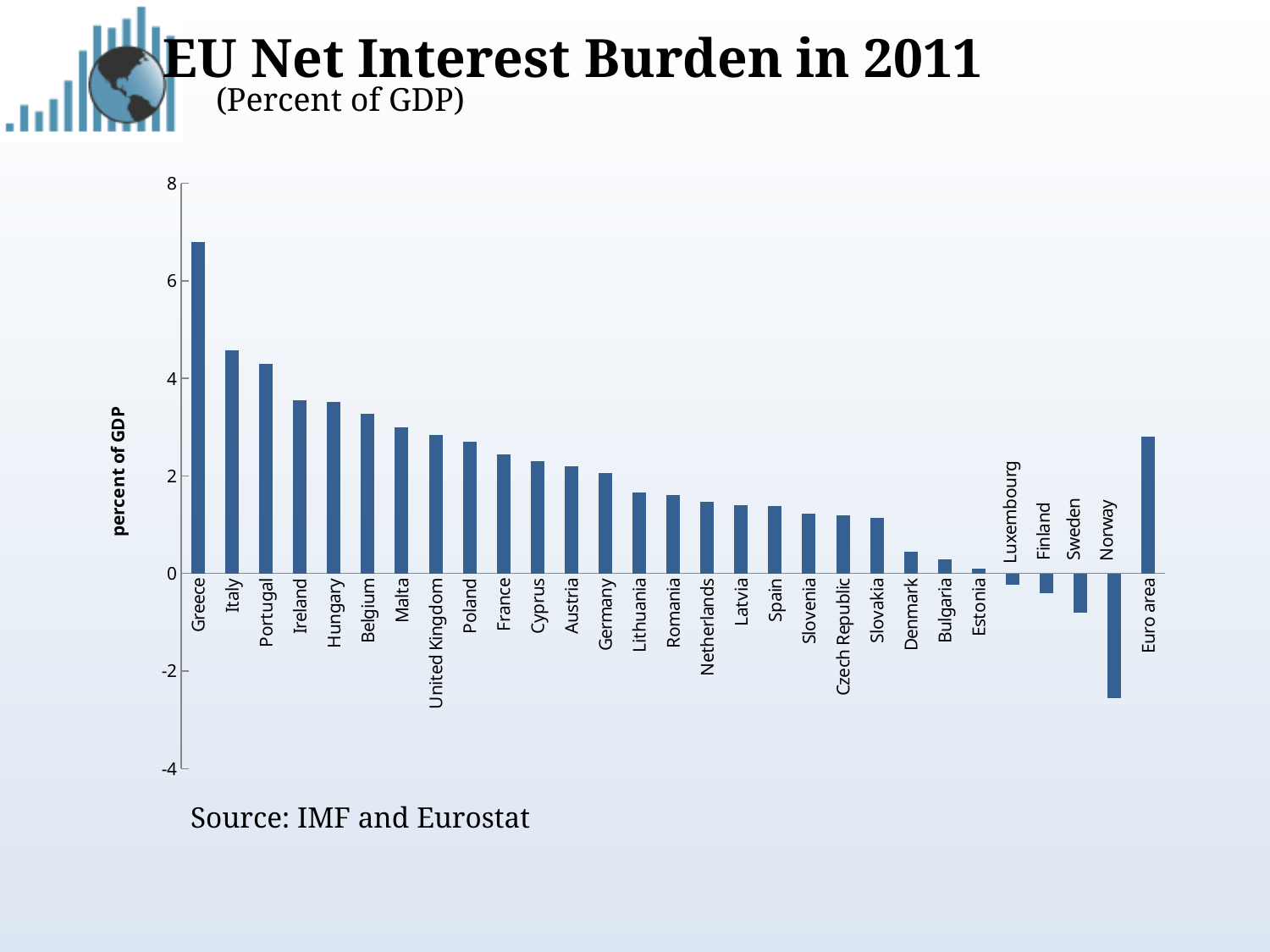
Is the value for Norway greater or less than -2? less Do the values for the individual countries rise or fall from left to right across the chart? fall What kind of chart is shown on the slide? bar chart Which country has the lowest (most negative) net interest burden in the chart? Norway What is the label on the vertical axis of the chart? percent of GDP Is the value for Spain greater or less than 2? less Is the value for Italy greater or less than 4? greater Which has the larger net interest burden, Portugal or Ireland? Portugal Which country has the highest net interest burden in the chart? Greece How many bars are plotted in the chart? 29